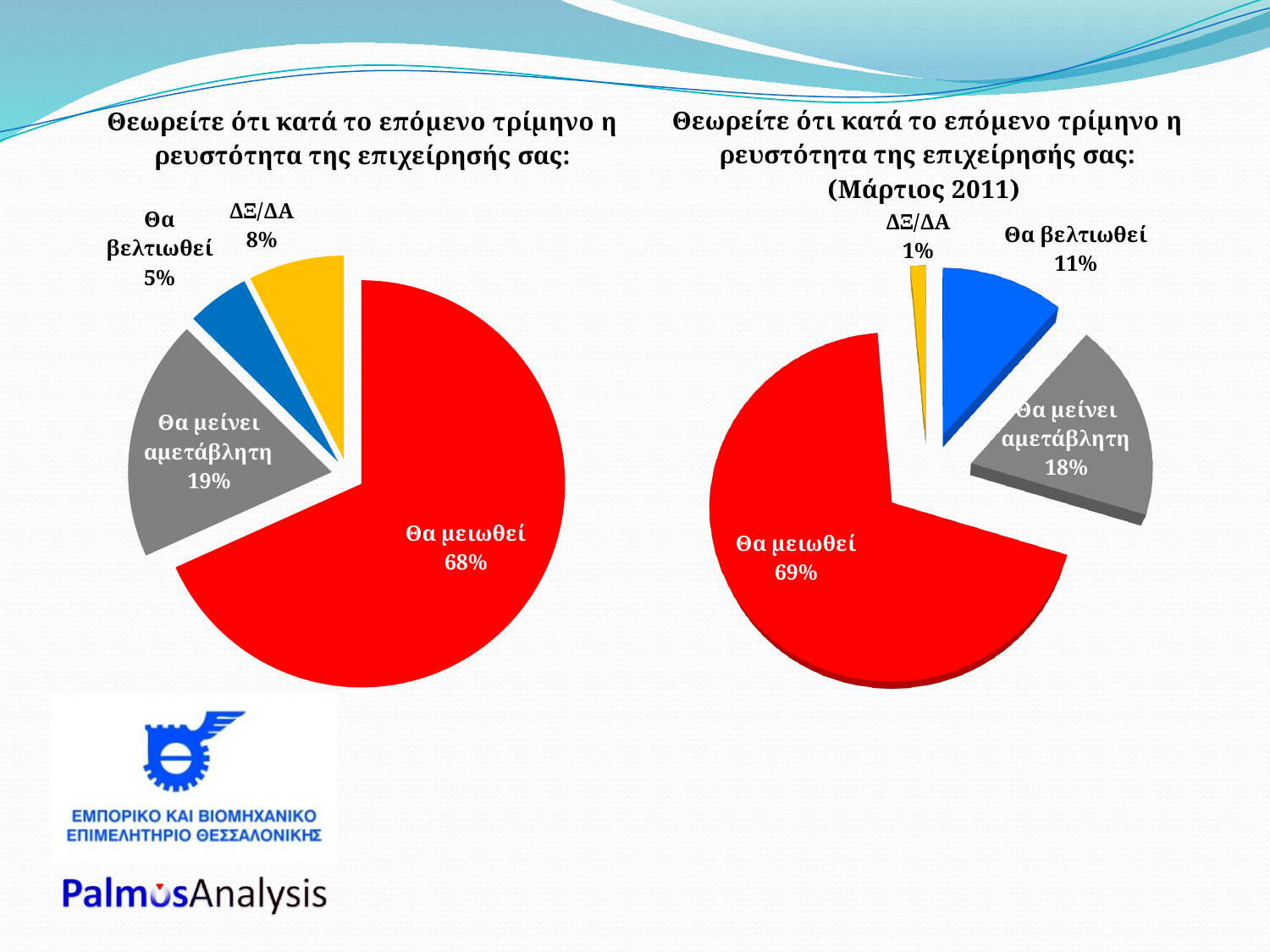
How many slices does the left pie chart have? 4 In the right pie chart (Μάρτιος 2011), what share of respondents answered "Θα βελτιωθεί"? 11% What type of chart is used on the right side of the slide (Μάρτιος 2011)? Pie chart In the left pie chart, what share of respondents answered "Θα μειωθεί"? 68% In the left pie chart, which category has the largest slice? Θα μειωθεί In the left pie chart, what is the difference between the "Θα μείνει αμετάβλητη" share and the "ΔΞ/ΔΑ" share? 11% In the right pie chart (Μάρτιος 2011), which category has the smallest slice? ΔΞ/ΔΑ In the right pie chart (Μάρτιος 2011), what percentage is shown for "ΔΞ/ΔΑ"? 1% Which chart shows a larger share for "Θα βελτιωθεί", the left pie chart or the right pie chart (Μάρτιος 2011)? The right pie chart (Μάρτιος 2011) In the left pie chart, what percentage is shown for "Θα μείνει αμετάβλητη"? 19% What is the difference between the "Θα μειωθεί" share in the right pie chart (Μάρτιος 2011) and in the left pie chart? 1% In the left pie chart, which category has the smallest slice? Θα βελτιωθεί